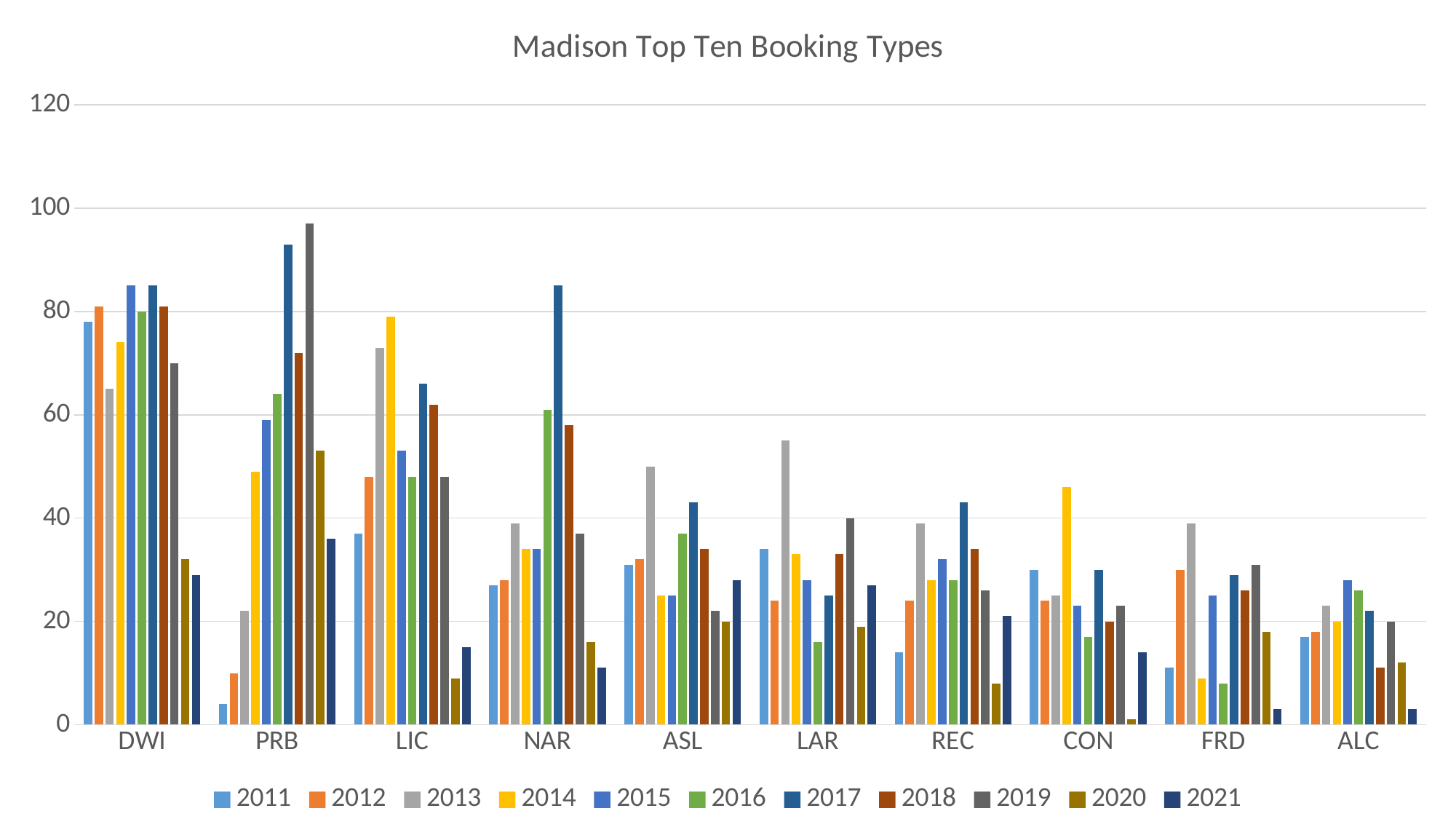
Is the value for 2013 in the LAR category greater or less than 40? greater Is the value for 2018 in the ALC category greater or less than 20? less What is the title of the chart? Madison Top Ten Booking Types Which year has the highest bar in the PRB category? 2019 How many series does the legend list? 11 How many booking type categories are shown on the x axis? 10 Which year has the lowest bar in the CON category? 2020 What kind of chart is shown on the slide? bar chart Is the value for 2011 in the DWI category greater or less than 60? greater Which year has the highest bar in the NAR category? 2017 Which year has the lowest bar in the PRB category? 2011 Which is larger: the 2016 value for NAR or the 2016 value for ASL? NAR